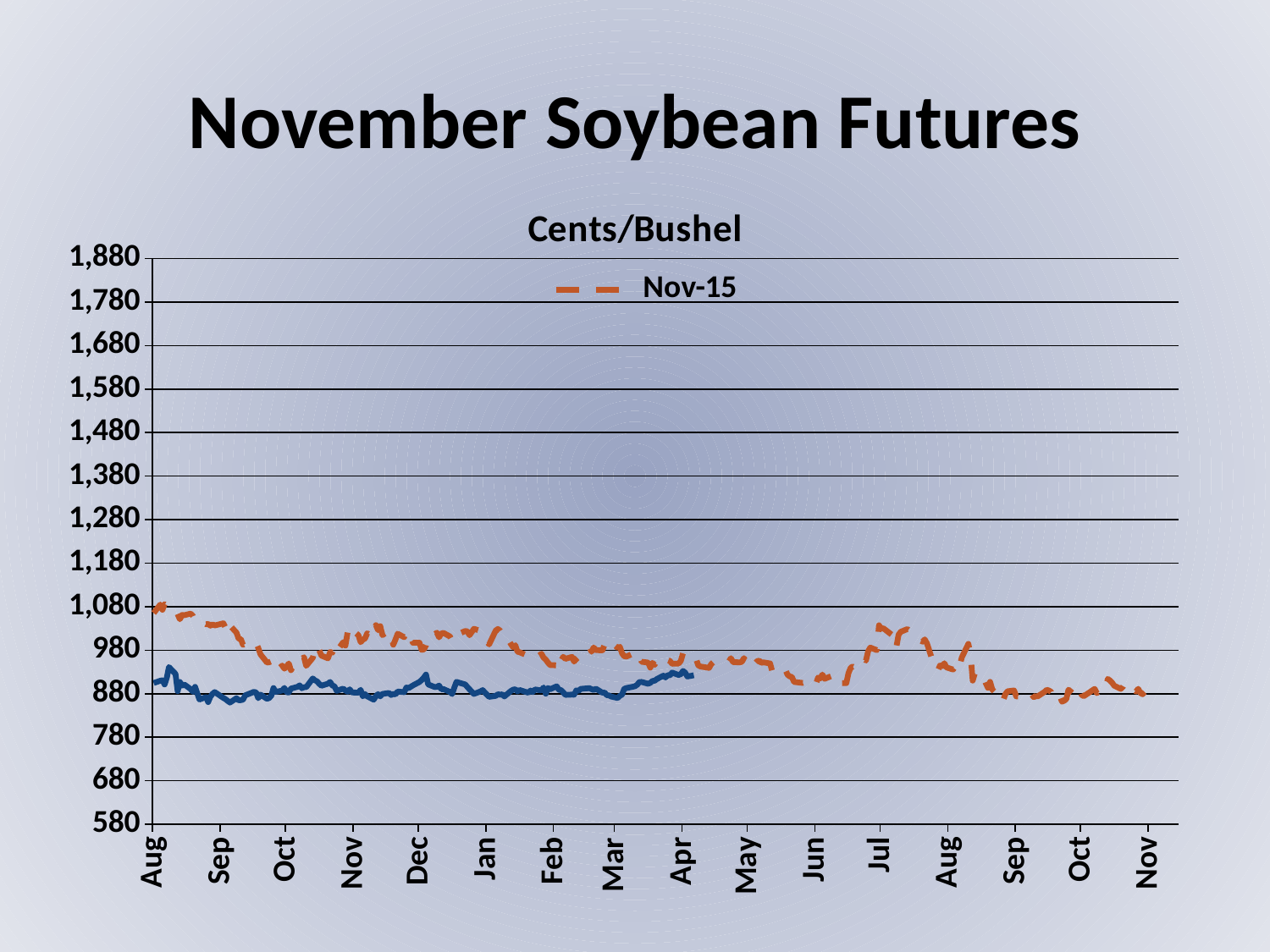
What is the title printed above the chart's plot area? Cents/Bushel How many series does the chart's legend list? 1 How many month labels are shown along the x axis? 16 Is the Nov-15 value at Jul greater or less than 980? greater At the first Sep label, which line is higher: the dashed Nov-15 line or the solid blue line? the dashed Nov-15 line Is the value of the solid blue line at the first Sep label greater or less than 980? less Does the Nov-15 line rise or fall from Jul to the final Nov label? fall What is the name of the series shown in the legend? Nov-15 Is the Nov-15 value at the final Nov label greater or less than 980? less What kind of chart is shown on the slide? line chart